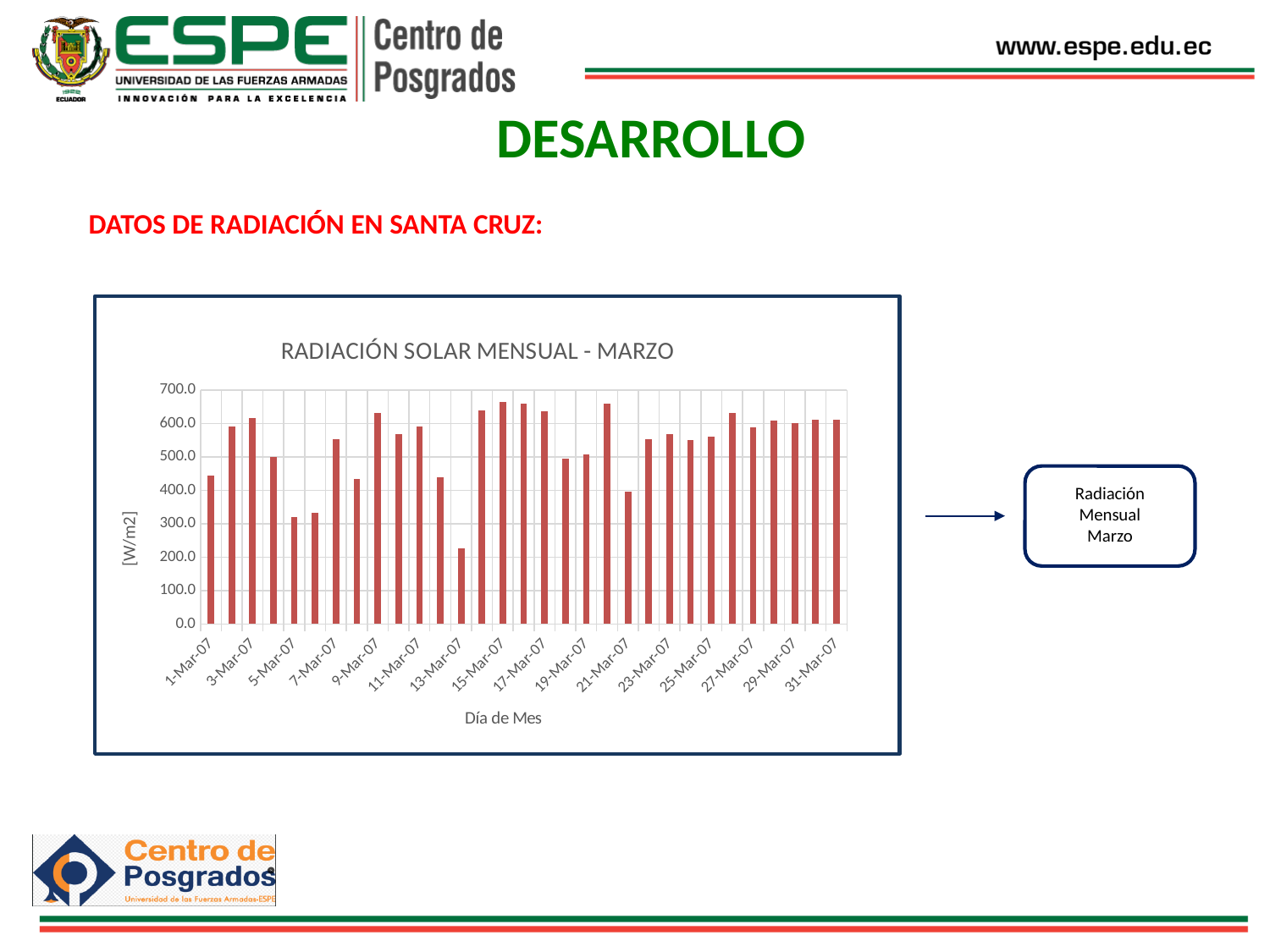
Which day has the larger value, 13-Mar-07 or 15-Mar-07? 15-Mar-07 How many bars (days) are plotted in the chart? 31 Which day has the larger value, 1-Mar-07 or 9-Mar-07? 9-Mar-07 What is the label of the vertical axis of the chart? [W/m2] What kind of chart is shown on the slide? bar chart What is the title of the chart? RADIACIÓN SOLAR MENSUAL - MARZO Which day has the lowest radiation value in the chart? 13-Mar-07 Is the value for 1-Mar-07 greater or less than 400? greater Is the value for 21-Mar-07 greater or less than 600? less Is the value for 13-Mar-07 greater or less than 300? less